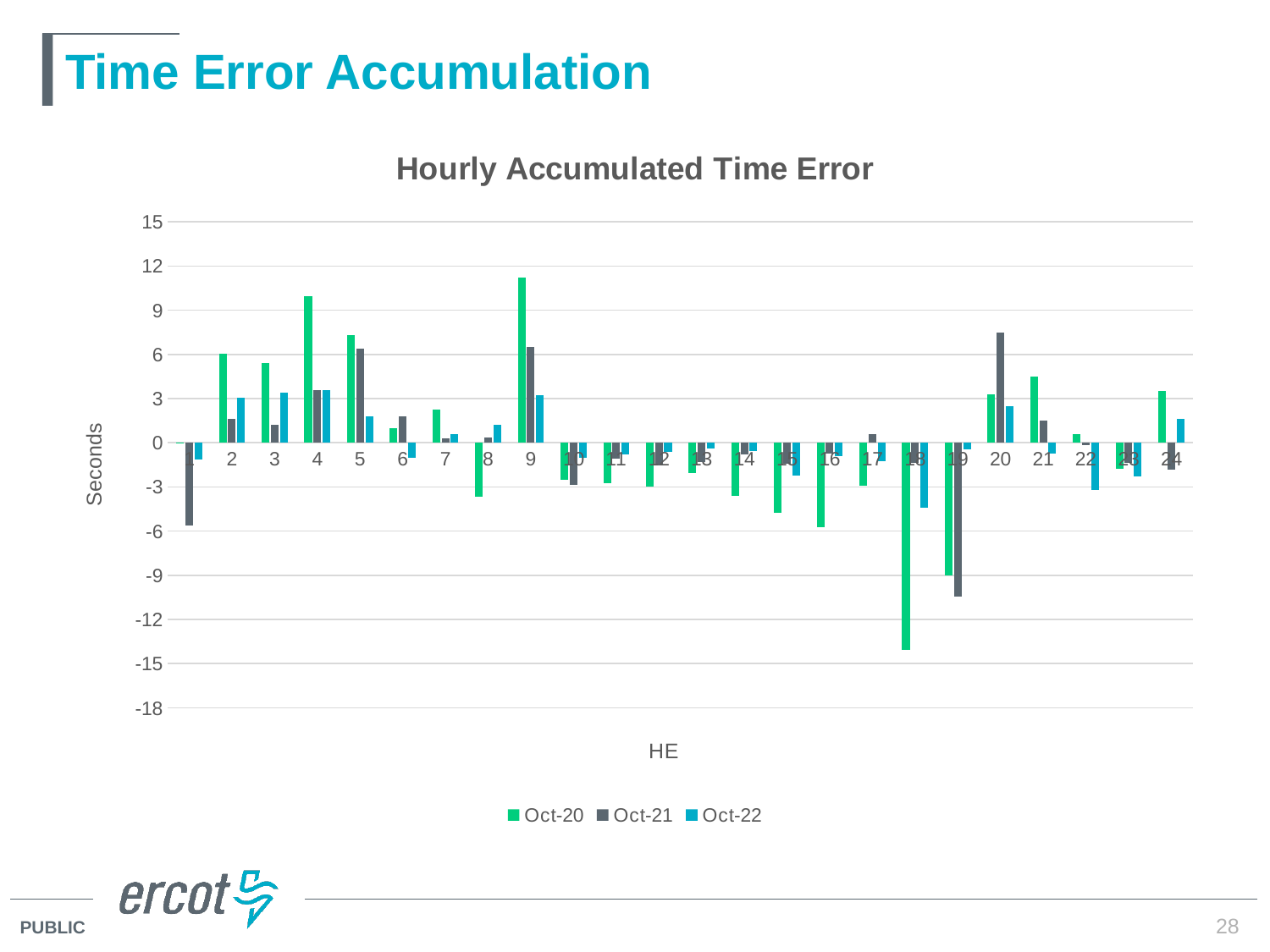
For the Oct-21 series, which hour has the lowest value? 19 How many series does the legend list? 3 Is the Oct-20 value at hour 18 greater or less than -12? less For the Oct-20 series, which hour has the lowest value? 18 What is the label on the vertical axis? Seconds For the Oct-20 series, which hour has the highest value? 9 What kind of chart is shown on the slide? Bar chart What is the title of the chart? Hourly Accumulated Time Error How many hour-ending categories are plotted along the x axis? 24 Is the Oct-20 value at hour 9 greater or less than 9? greater At hour 20, which series has the larger value, Oct-20 or Oct-21? Oct-21 Is the Oct-21 value at hour 1 greater or less than -3? less